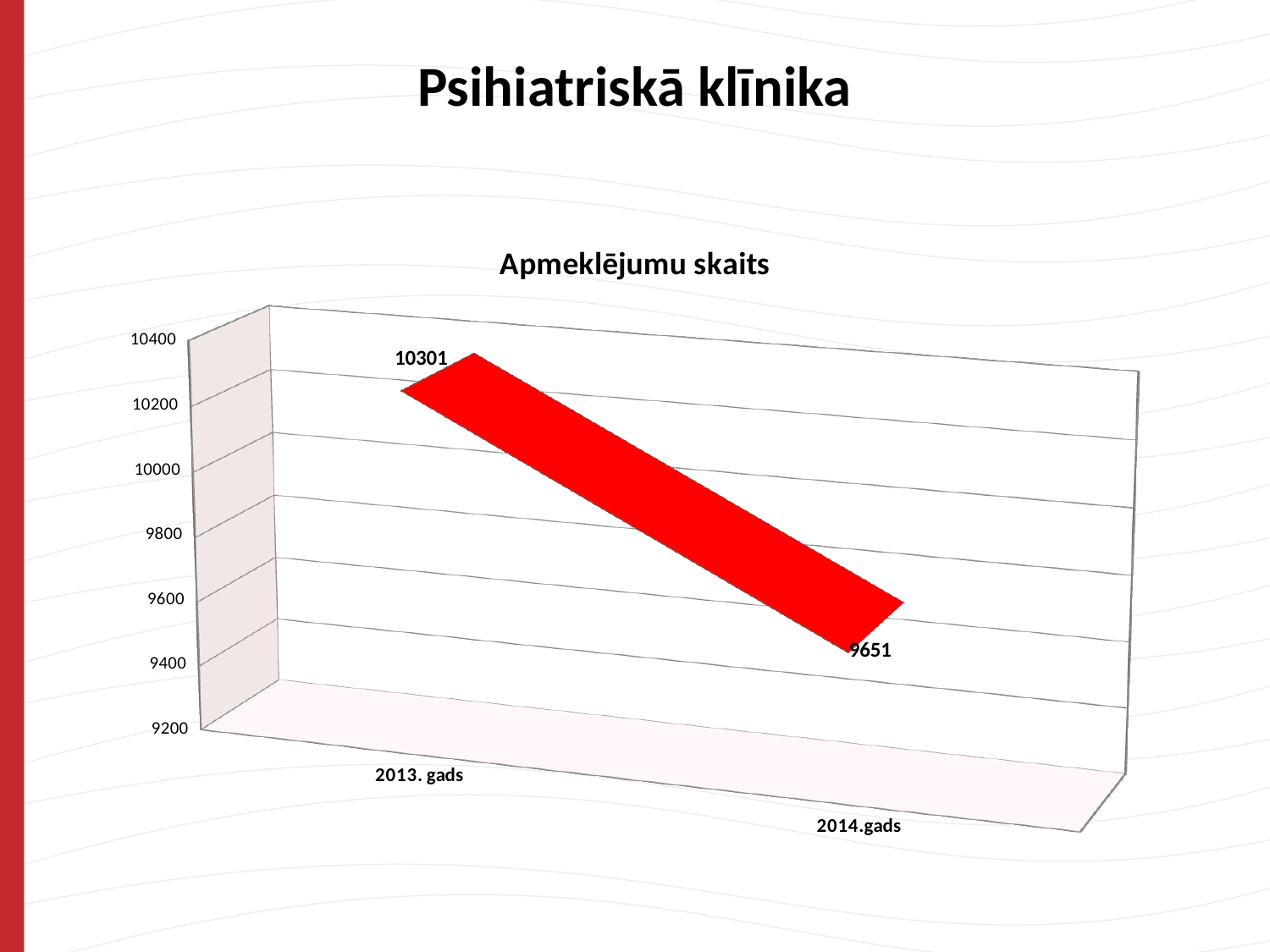
Do the values rise or fall from 2013. gads to 2014.gads? fall Is the value for 2014.gads greater or less than 10000? less Which is larger, the value for 2013. gads or for 2014.gads? 2013. gads What kind of chart is shown? 3D line chart What is the difference between the values for 2013. gads and 2014.gads? 650 How many data points are plotted on the chart? 2 What is the title of the chart? Apmeklējumu skaits Is the value for 2013. gads greater or less than 10200? greater Which year has the highest value? 2013. gads What is the value for 2013. gads? 10301 Which year has the lowest value? 2014.gads What is the value for 2014.gads? 9651